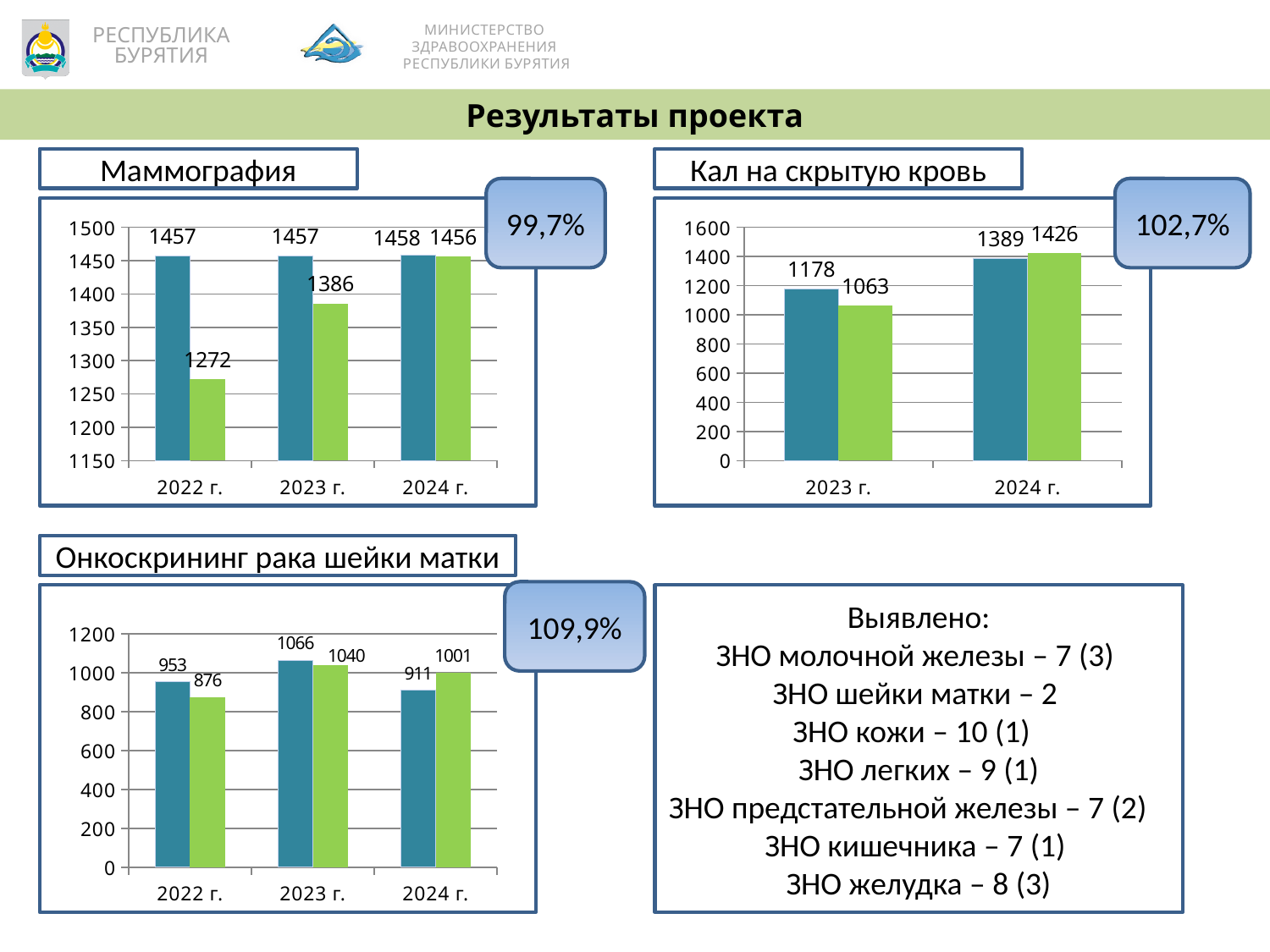
In the 'Онкоскрининг рака шейки матки' chart, what is the value of the blue bar for 2024 г.? 911 In the 'Кал на скрытую кровь' chart, do the green bar values rise or fall from 2023 г. to 2024 г.? rise In the 'Маммография' chart, what is the value of the green bar for 2022 г.? 1272 In the 'Онкоскрининг рака шейки матки' chart, which year has the lowest green bar? 2022 г. In the 'Онкоскрининг рака шейки матки' chart, which year has the highest blue bar? 2023 г. In the 'Маммография' chart, what is the difference between the blue and green bars for 2023 г.? 71 In the 'Кал на скрытую кровь' chart, what is the value of the green bar for 2024 г.? 1426 In the 'Маммография' chart, how many year categories are shown on the x axis? 3 In the 'Кал на скрытую кровь' chart, what is the difference between the green bar values for 2024 г. and 2023 г.? 363 In the 'Кал на скрытую кровь' chart, which is larger for 2023 г., the blue bar or the green bar? the blue bar What type of chart is the 'Онкоскрининг рака шейки матки' chart? bar chart In the 'Маммография' chart, what is the value of the blue bar for 2024 г.? 1458